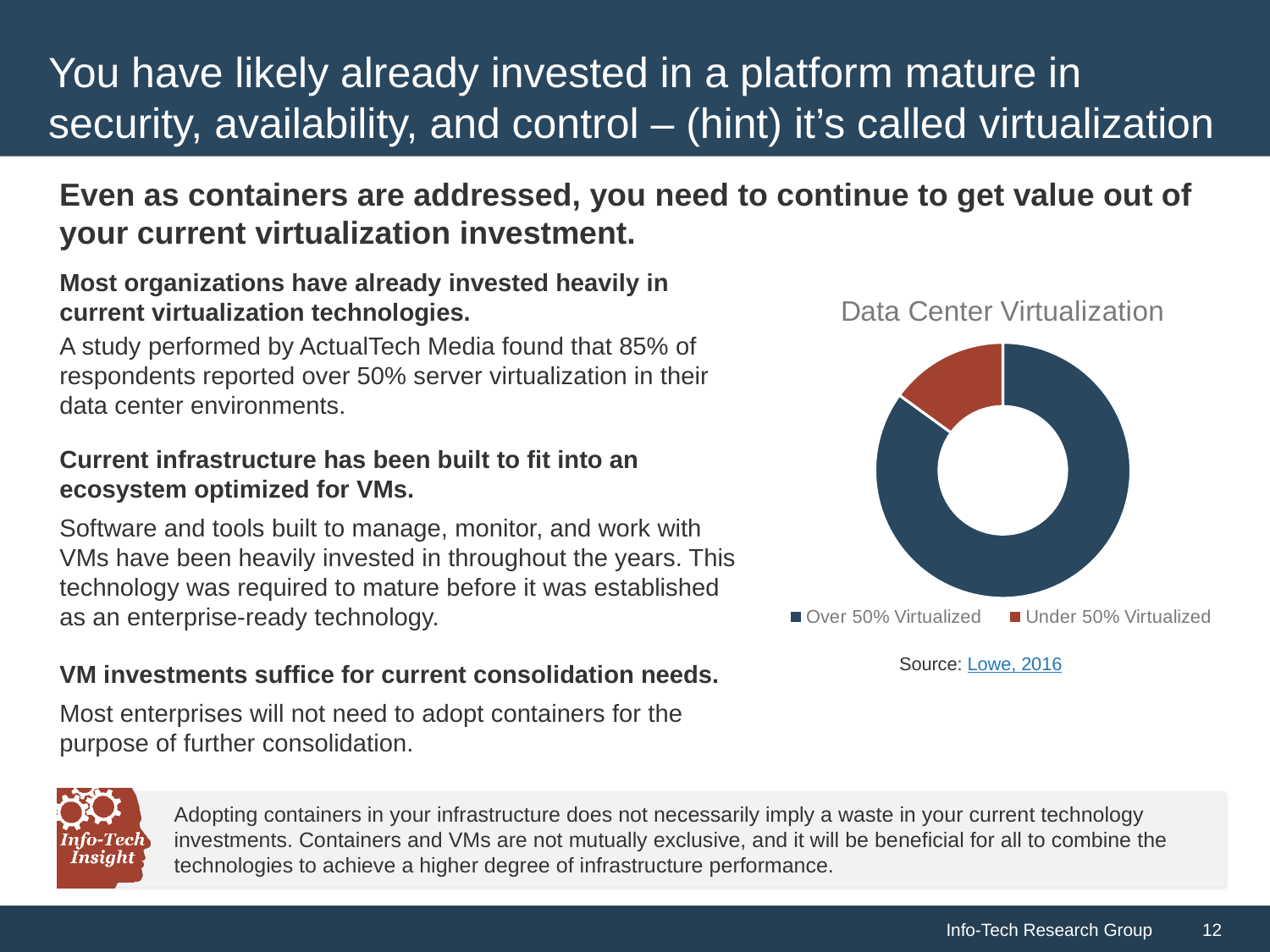
What colour represents Under 50% Virtualized in the Data Center Virtualization chart? Red What is the title of the chart on the slide? Data Center Virtualization In the Data Center Virtualization chart, which slice is larger: Over 50% Virtualized or Under 50% Virtualized? Over 50% Virtualized How many slices does the Data Center Virtualization chart have? 2 How many entries does the legend of the Data Center Virtualization chart list? 2 What kind of chart is shown on the slide? Doughnut chart Which category takes up the largest share of the Data Center Virtualization chart? Over 50% Virtualized Which category takes up the smallest share of the Data Center Virtualization chart? Under 50% Virtualized Does the Over 50% Virtualized slice make up more or less than half of the Data Center Virtualization chart? More